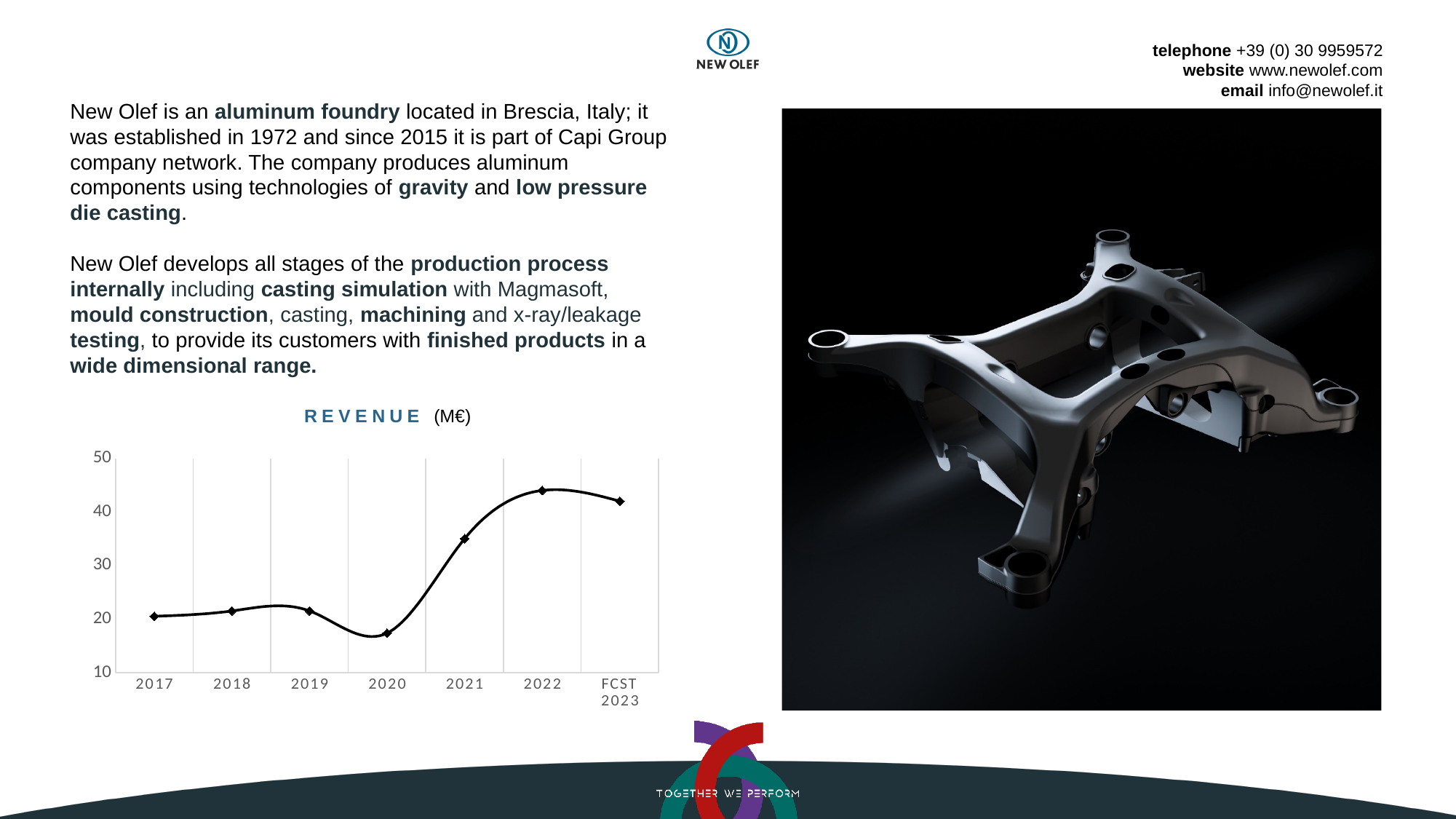
Is the revenue value for 2020 greater or less than 20? less In which year does the REVENUE chart reach its highest value? 2022 Does revenue rise or fall between 2020 and 2022? rise What kind of chart is shown under the title REVENUE (M€)? line chart In which year does the REVENUE chart show its lowest value? 2020 How many years (points) are plotted on the REVENUE chart's x axis? 7 Is the revenue value for 2021 greater or less than 30? greater Which has the larger revenue, 2022 or FCST 2023? 2022 Is the revenue value for 2017 greater or less than 30? less What unit is shown next to the REVENUE chart title? M€ Which year has the larger revenue, 2020 or 2021? 2021